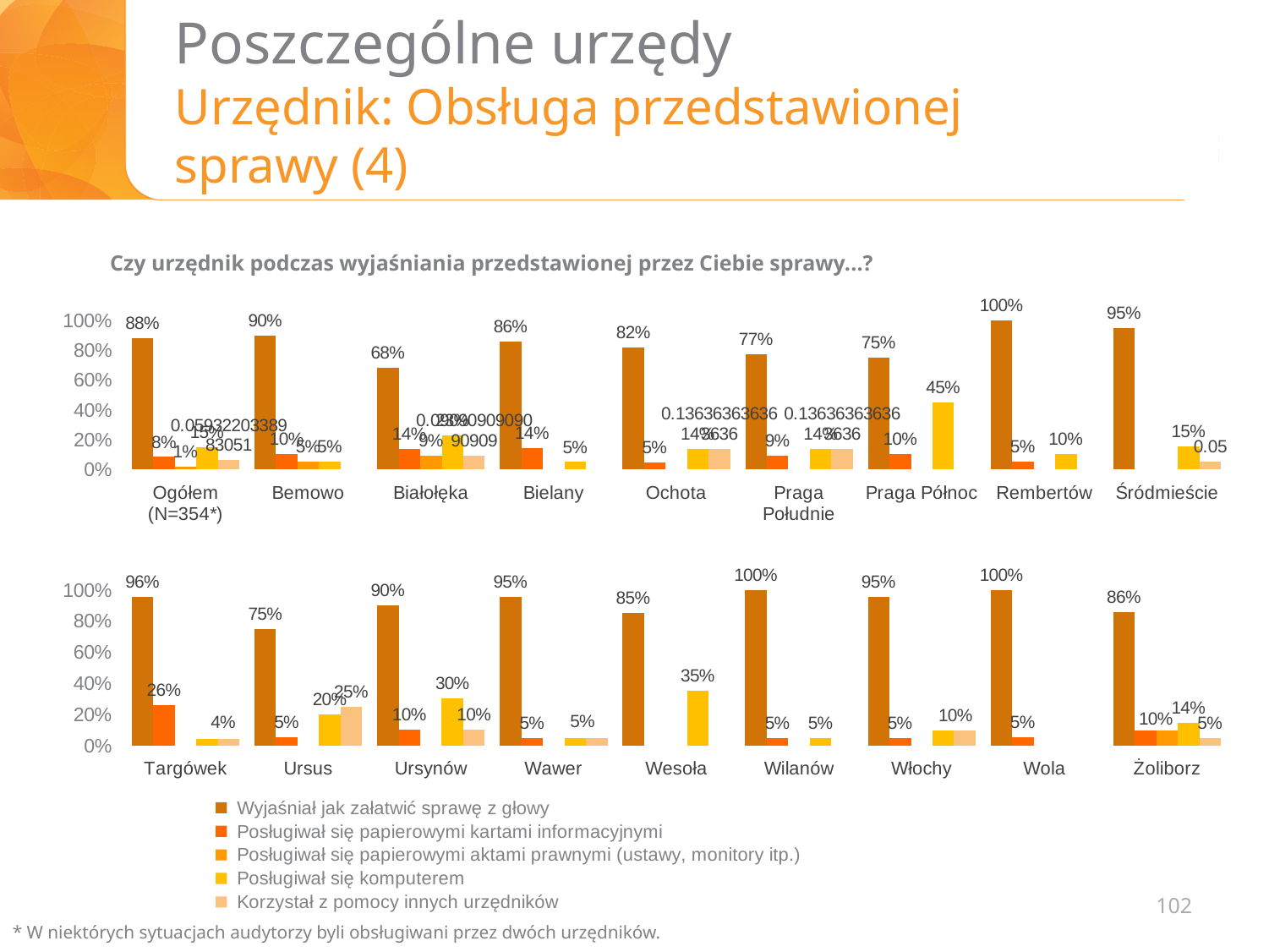
What type of chart is the top chart on the slide? bar chart In the top chart, which category has the lowest value for 'Wyjaśniał jak załatwić sprawę z głowy'? Białołęka In the top chart, what is the value for 'Wyjaśniał jak załatwić sprawę z głowy' for Białołęka? 68% In the bottom chart, which category has the lowest value for 'Wyjaśniał jak załatwić sprawę z głowy'? Ursus In the top chart, what is the value for 'Posługiwał się komputerem' for Praga Północ? 45% In the bottom chart, what is the value for 'Posługiwał się komputerem' for Wesoła? 35% In the top chart, what is the difference between the 'Wyjaśniał jak załatwić sprawę z głowy' values for Śródmieście and Białołęka? 27 percentage points In the bottom chart, what is the value for 'Posługiwał się papierowymi kartami informacyjnymi' for Targówek? 26% In the top chart, what is the value for 'Wyjaśniał jak załatwić sprawę z głowy' for Rembertów? 100% In the top chart, which has the higher value for 'Wyjaśniał jak załatwić sprawę z głowy': Bemowo or Ochota? Bemowo How many series does the legend list for the charts on the slide? 5 In the top chart, how many categories are shown on the x axis? 9